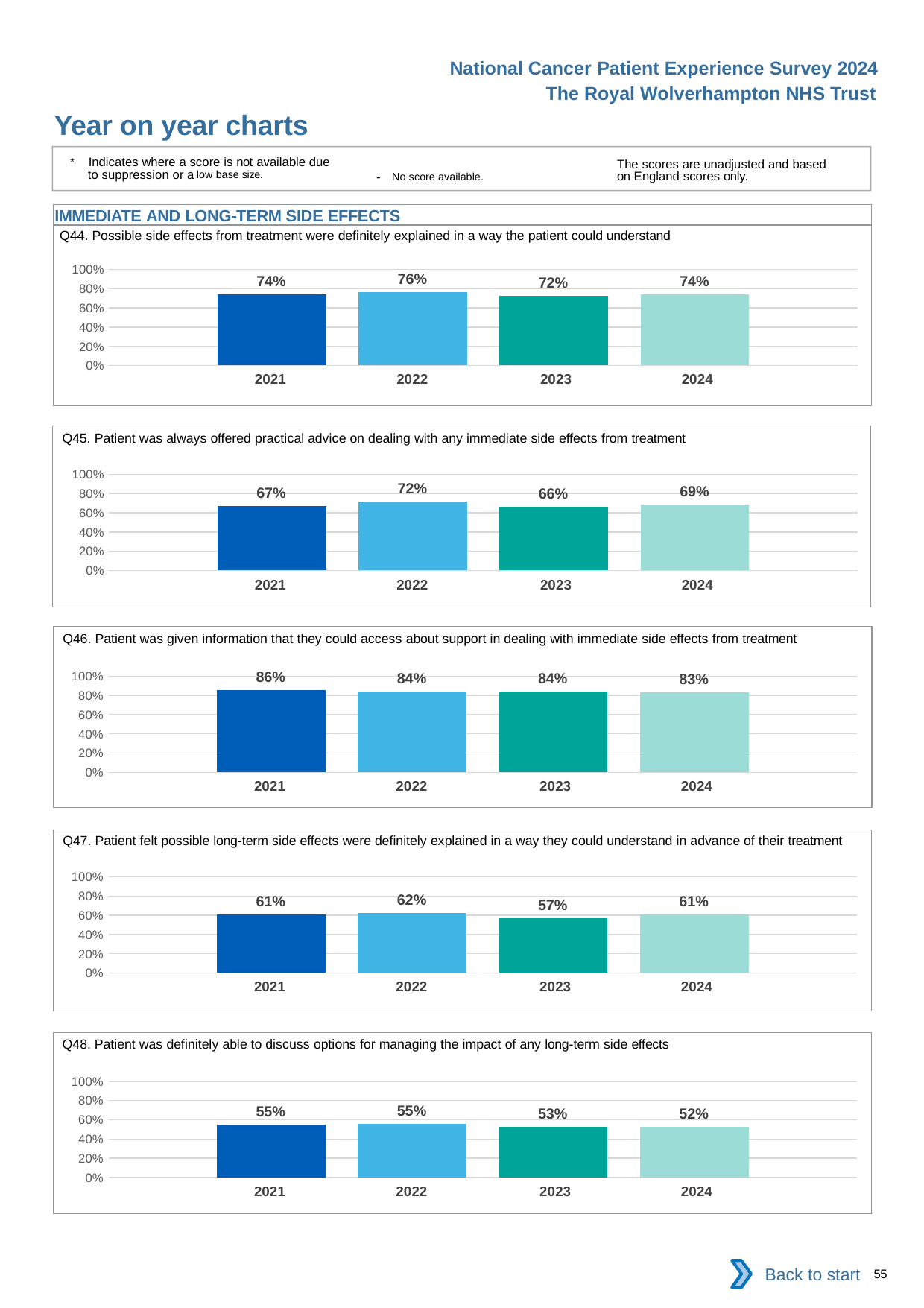
In the Q47 chart, what is the value for 2023? 57% In the Q46 chart, do the values generally rise or fall from 2021 to 2024? fall What kind of chart is the Q48 chart? bar chart In the Q45 chart, what is the difference between the 2022 and 2023 values? 6 percentage points In the Q47 chart, which is larger, the value for 2022 or the value for 2023? 2022 In the Q44 chart, what is the value for 2022? 76% In the Q46 chart, what is the value for 2024? 83% In the Q45 chart, which year has the highest value? 2022 In the Q48 chart, what is the difference between the 2021 and 2024 values? 3 percentage points In the Q44 chart, which year has the lowest value? 2023 How many charts are shown on the slide? 5 In the Q48 chart, how many years are plotted? 4